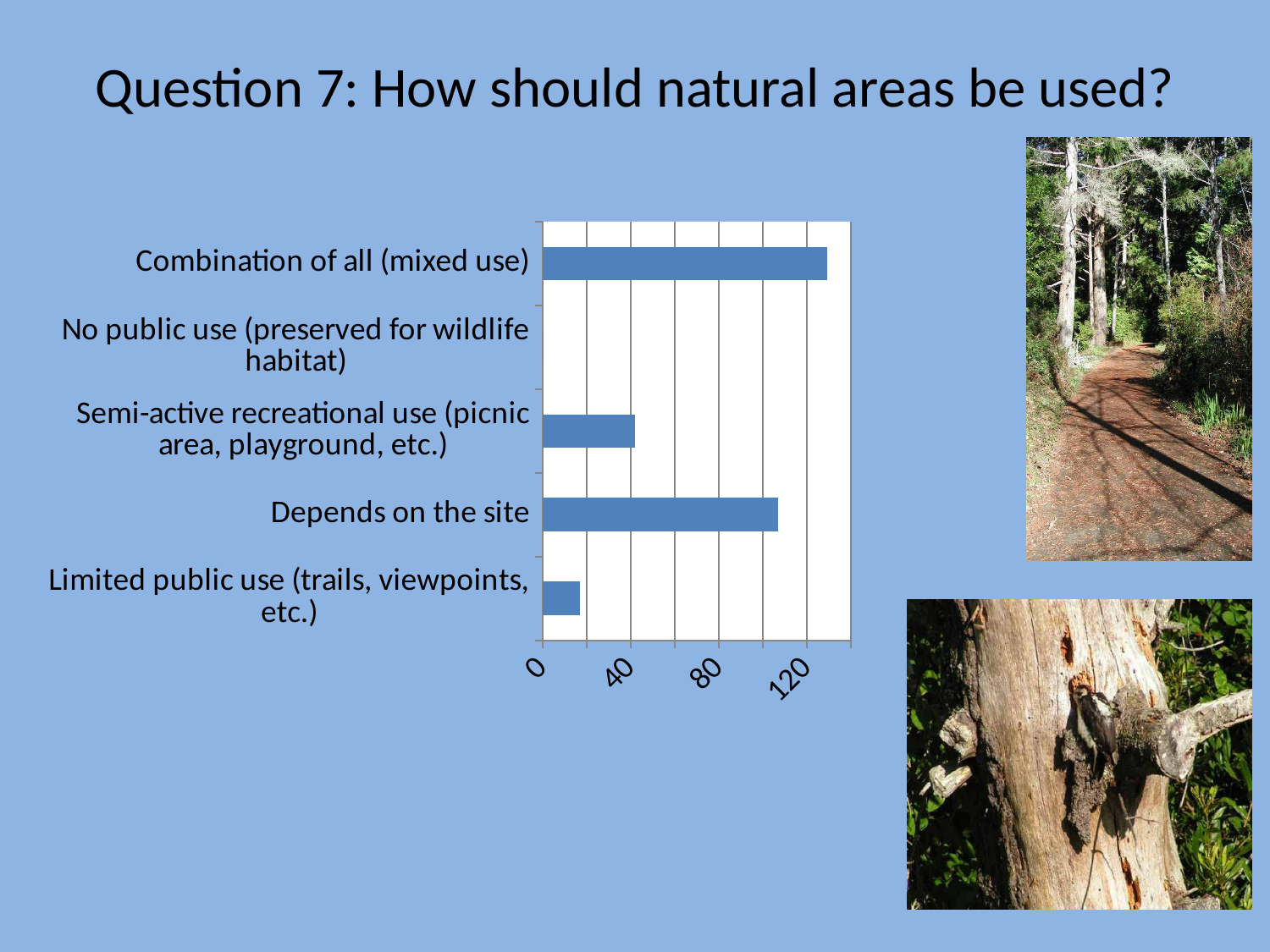
How many categories are shown in the bar chart? 5 Which is larger: the value for Limited public use (trails, viewpoints, etc.) or the value for Semi-active recreational use (picnic area, playground, etc.)? Semi-active recreational use (picnic area, playground, etc.) Is the value for Semi-active recreational use (picnic area, playground, etc.) greater or less than 80? less Which is larger: the value for Depends on the site or the value for Semi-active recreational use (picnic area, playground, etc.)? Depends on the site Is the value for Combination of all (mixed use) greater or less than 120? greater Is the value for Limited public use (trails, viewpoints, etc.) greater or less than 40? less What kind of chart is shown on the slide? bar chart Which category has the highest value in the bar chart? Combination of all (mixed use) What is the title of the slide containing the bar chart? Question 7: How should natural areas be used? Which category has the lowest value in the bar chart? No public use (preserved for wildlife habitat)